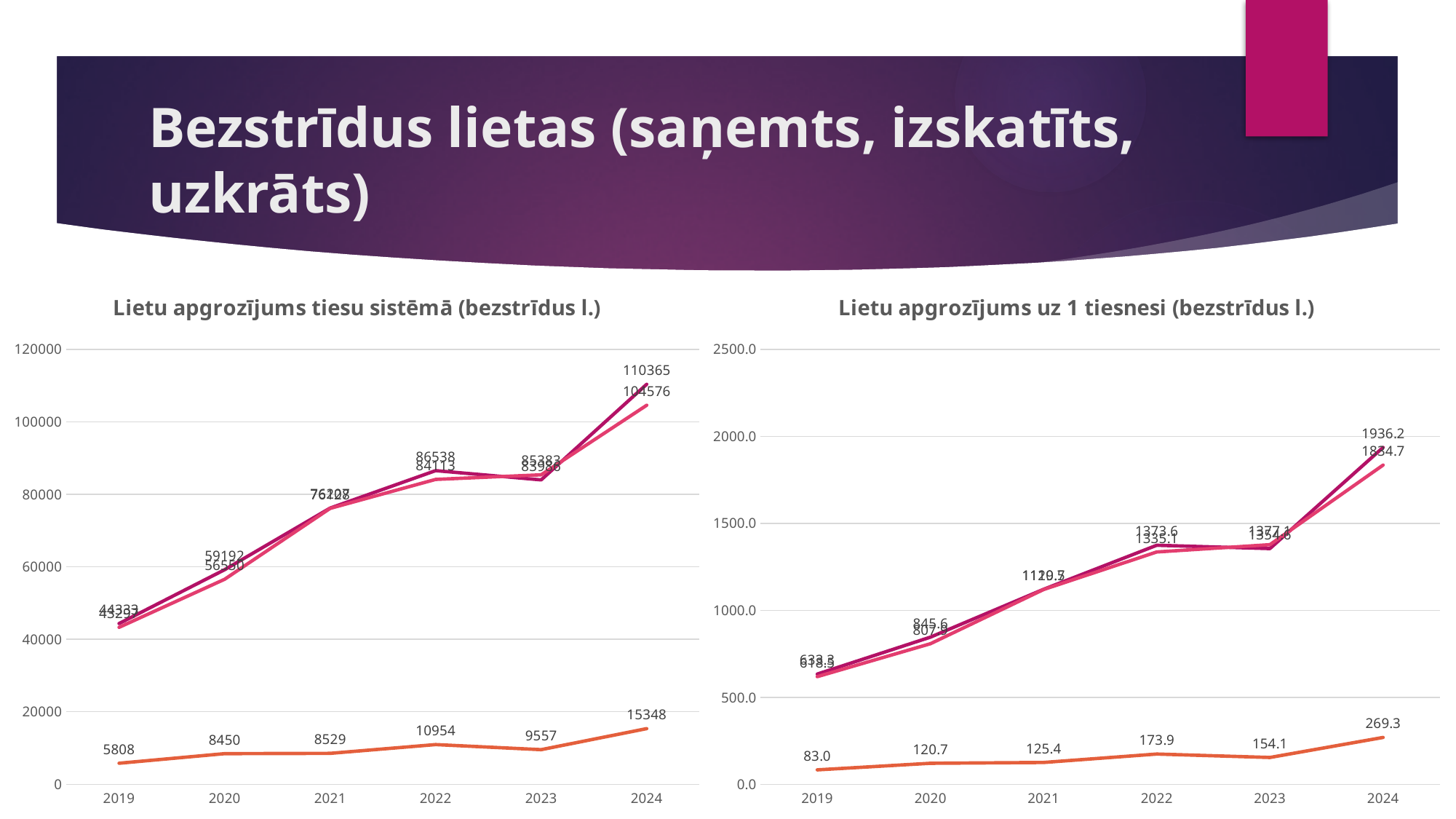
In the right chart, 'Lietu apgrozījums uz 1 tiesnesi (bezstrīdus l.)', what is the highest value labelled in 2024? 1936.2 In the right chart, 'Lietu apgrozījums uz 1 tiesnesi (bezstrīdus l.)', what is the difference between the lowest (orange) line's values in 2024 and 2023? 115.2 How many years are shown on the x axis of the left chart, 'Lietu apgrozījums tiesu sistēmā (bezstrīdus l.)'? 6 In the left chart, 'Lietu apgrozījums tiesu sistēmā (bezstrīdus l.)', what is the value of the lowest (orange) line in 2024? 15348 What kind of chart is the left chart, 'Lietu apgrozījums tiesu sistēmā (bezstrīdus l.)'? line chart In the left chart, 'Lietu apgrozījums tiesu sistēmā (bezstrīdus l.)', in which year does the lowest (orange) line reach its highest value? 2024 In the left chart, 'Lietu apgrozījums tiesu sistēmā (bezstrīdus l.)', by how much does the lowest (orange) line's value in 2024 exceed its value in 2019? 9540 In the left chart, 'Lietu apgrozījums tiesu sistēmā (bezstrīdus l.)', are the two upper lines in 2024 greater or less than 100000? greater In the left chart, 'Lietu apgrozījums tiesu sistēmā (bezstrīdus l.)', what is the value of the lowest (orange) line in 2019? 5808 In the left chart, 'Lietu apgrozījums tiesu sistēmā (bezstrīdus l.)', what is the highest value labelled in 2024? 110365 In the right chart, 'Lietu apgrozījums uz 1 tiesnesi (bezstrīdus l.)', what is the value of the lowest (orange) line in 2022? 173.9 In the right chart, 'Lietu apgrozījums uz 1 tiesnesi (bezstrīdus l.)', is the lowest (orange) line's value larger in 2022 or in 2023? 2022